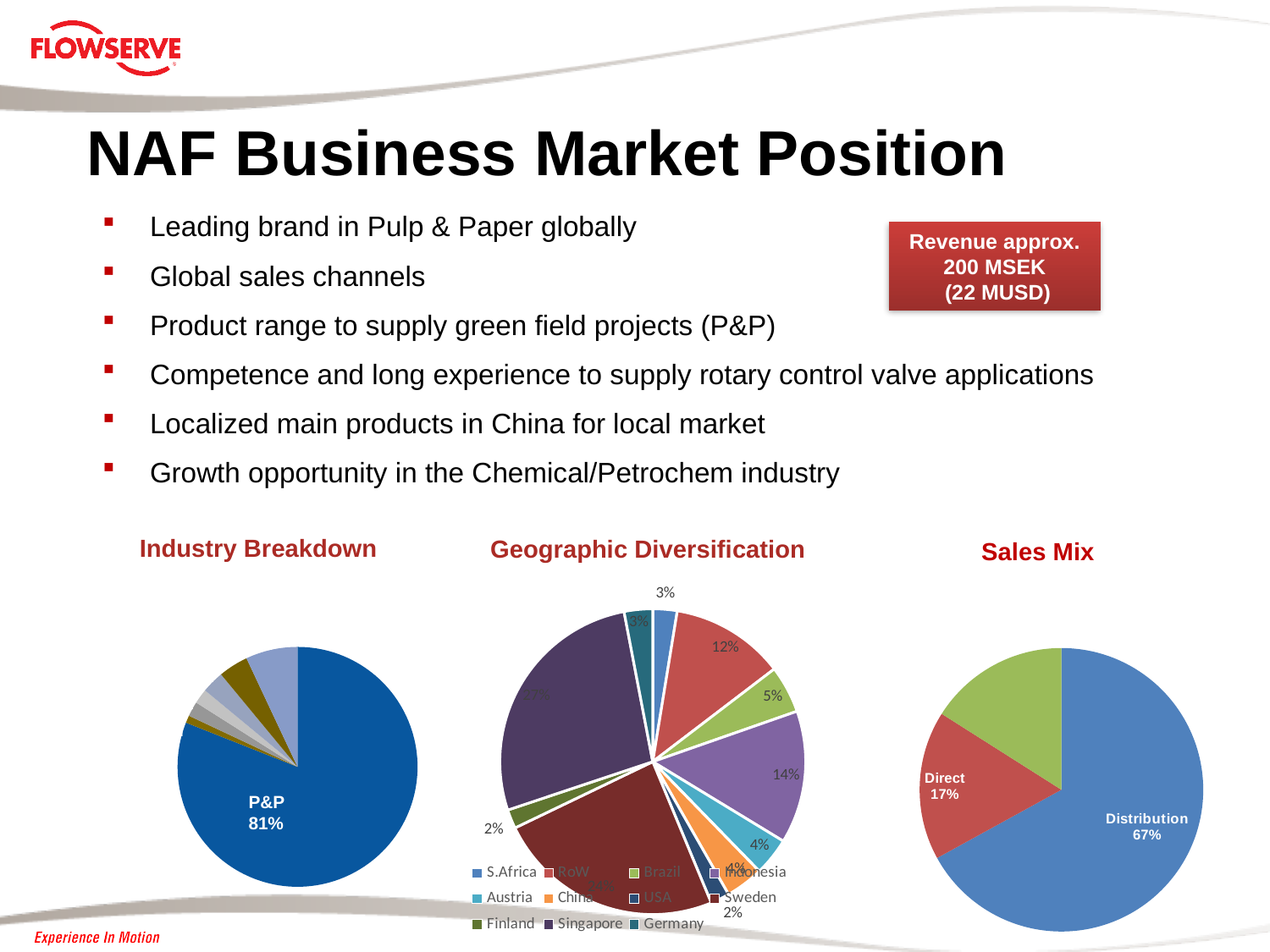
What kind of chart is the Sales Mix chart? Pie chart In the Geographic Diversification chart, how many entries does the legend list? 11 In the Sales Mix chart, how many slices does the pie have? 3 In the Geographic Diversification chart, what is the smallest percentage label shown on the pie? 2% In the Industry Breakdown chart, what share does P&P hold? 81% In the Sales Mix chart, what is the difference between Distribution and Direct? 50% In the Sales Mix chart, which is larger, Distribution or Direct? Distribution What kind of chart is the Industry Breakdown chart? Pie chart In the Geographic Diversification chart, what is the largest percentage label shown on the pie? 27% In the Sales Mix chart, what is the value for Distribution? 67% What is the title of the middle chart on the slide? Geographic Diversification In the Sales Mix chart, what is the value for Direct? 17%